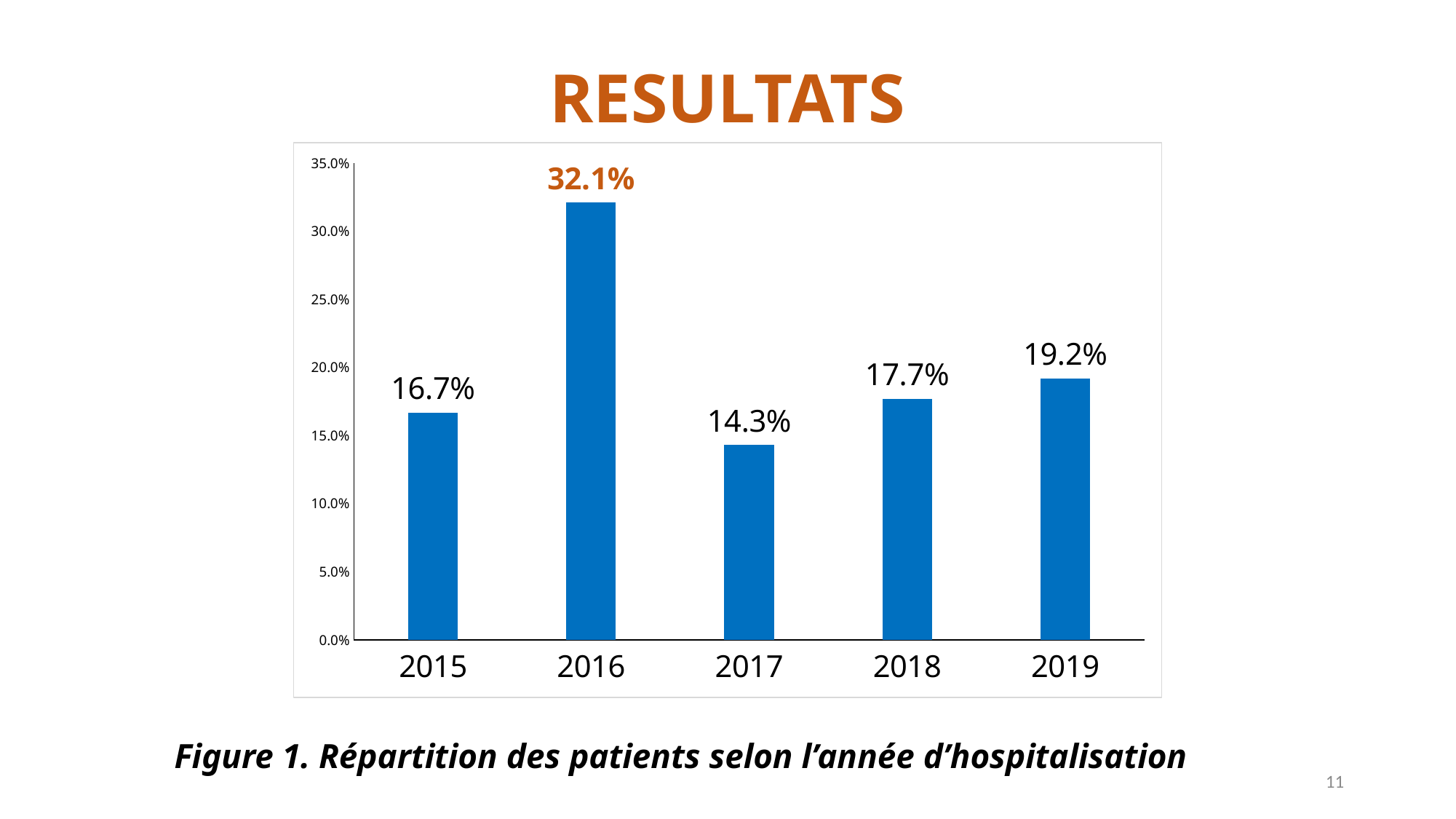
Which year has the highest value? 2016 Is the value for 2016 greater or less than 30.0%? greater What is the value for 2016? 32.1% Which year has the lowest value? 2017 What is the difference between the values for 2016 and 2017? 17.8% How many years are shown on the x axis? 5 What is the value for 2017? 14.3% What is the value for 2019? 19.2% What kind of chart is shown on the slide? Bar chart What is the caption of the figure below the chart? Figure 1. Répartition des patients selon l’année d’hospitalisation Which is larger, the value for 2015 or the value for 2018? 2018 What is the difference between the values for 2019 and 2018? 1.5%